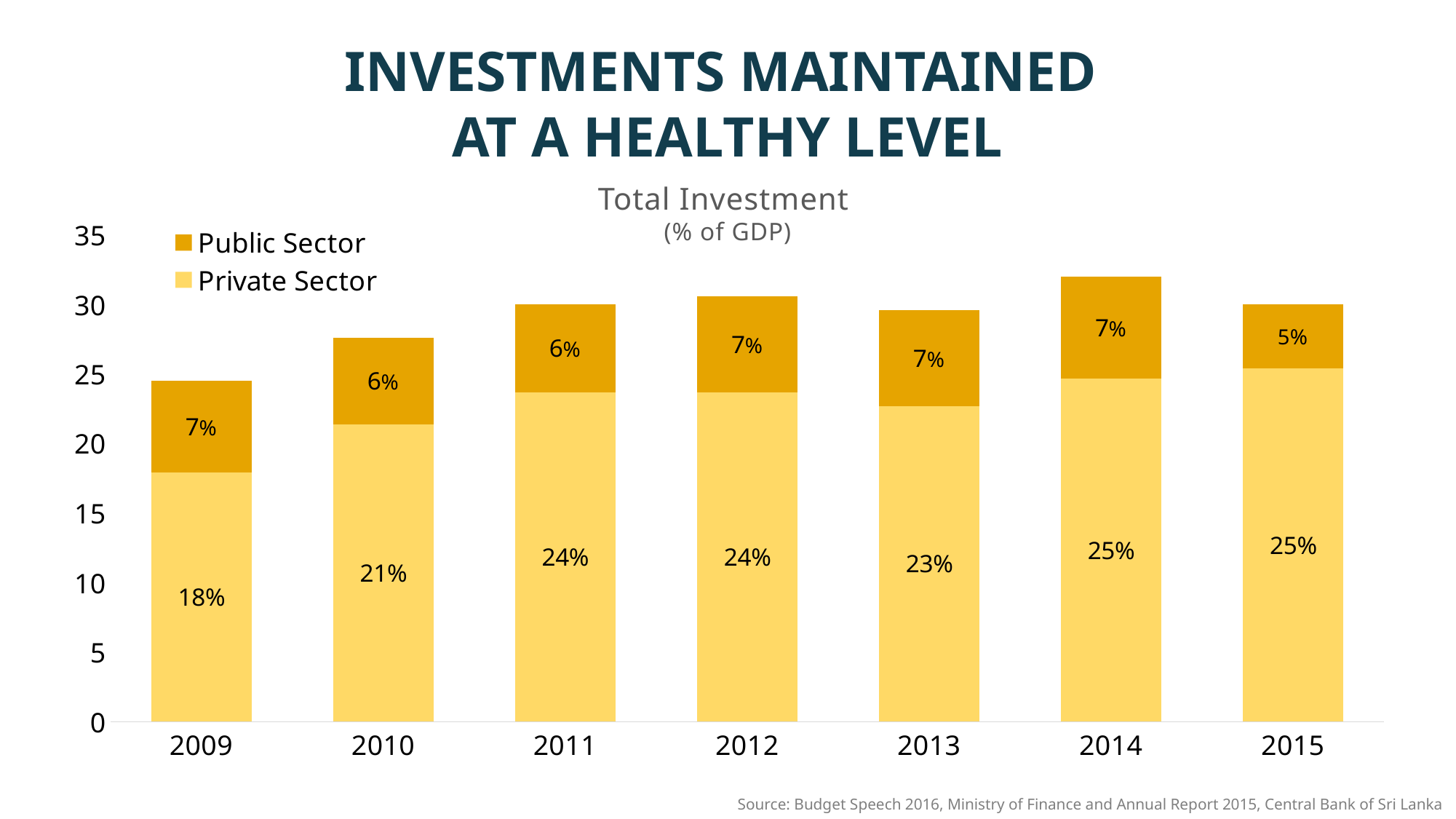
Is the Private Sector value for 2010 larger or smaller than the Private Sector value for 2012? smaller Which year has the lowest Public Sector value? 2015 Which year has the lowest Private Sector value? 2009 What is the difference between the Private Sector values for 2015 and 2009? 7 percentage points What is the total of the 2014 stacked bar (Public Sector plus Private Sector)? 32% Which year has the tallest total investment bar? 2014 What is the Private Sector value for 2013? 23% How many years are shown on the x axis? 7 What is the Public Sector value for 2015? 5% Is the total height of the 2014 bar greater or less than 30? greater What is the Private Sector value for 2009? 18% How many series does the legend list? 2